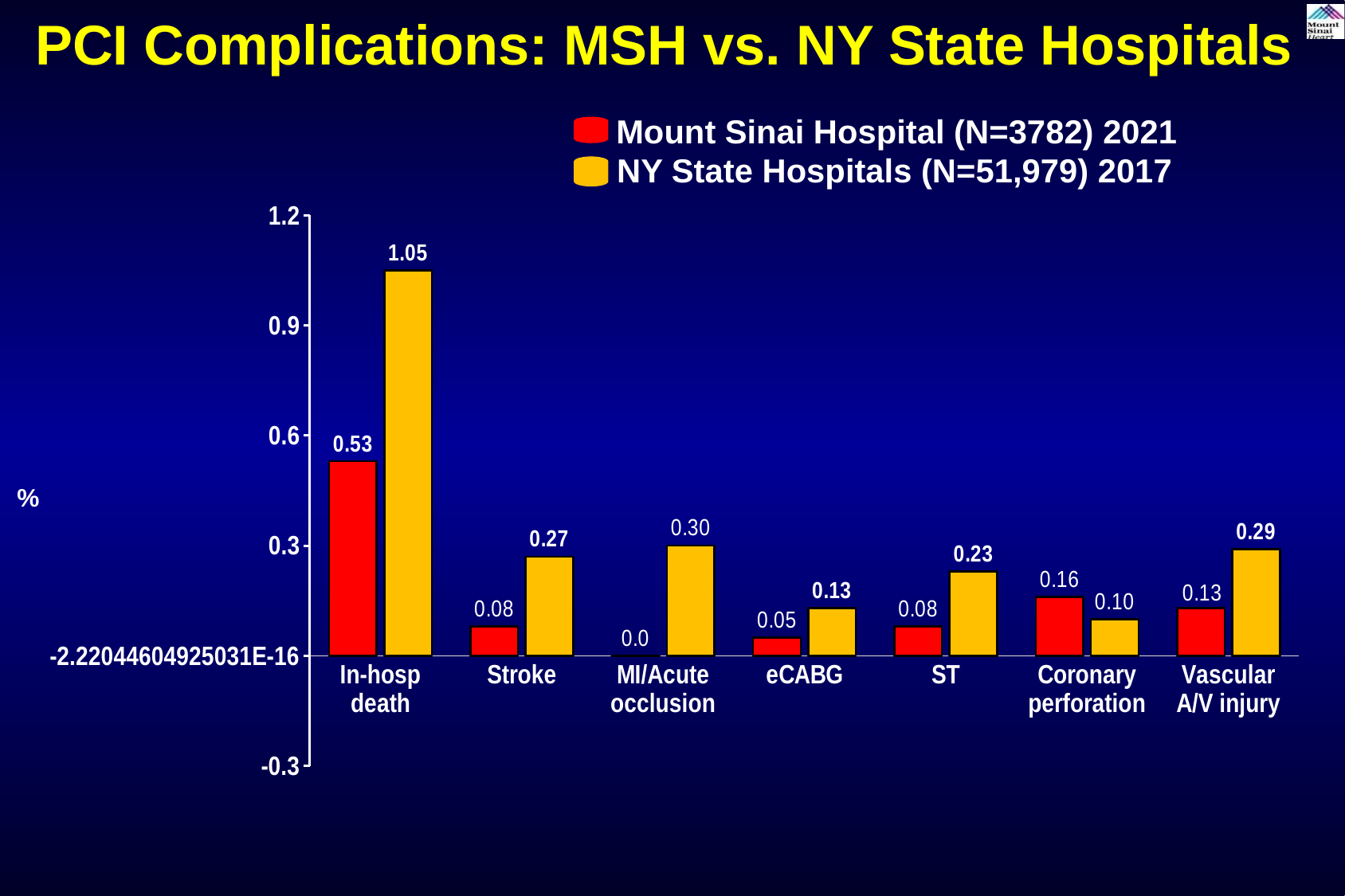
What is the value for NY State Hospitals for In-hosp death? 1.05 Which category has the lowest value for Mount Sinai Hospital? MI/Acute occlusion What is the value for NY State Hospitals for MI/Acute occlusion? 0.30 Which category has the highest value for NY State Hospitals? In-hosp death What is the value for Mount Sinai Hospital for In-hosp death? 0.53 What kind of chart is shown on the slide? Bar chart How many series does the legend list? 2 What is the difference between the NY State Hospitals and Mount Sinai Hospital values for In-hosp death? 0.52 For Coronary perforation, which series has the larger value, Mount Sinai Hospital or NY State Hospitals? Mount Sinai Hospital What is the value for Mount Sinai Hospital for Coronary perforation? 0.16 Which colour represents NY State Hospitals in the chart? Yellow How many complication categories are shown on the x axis? 7